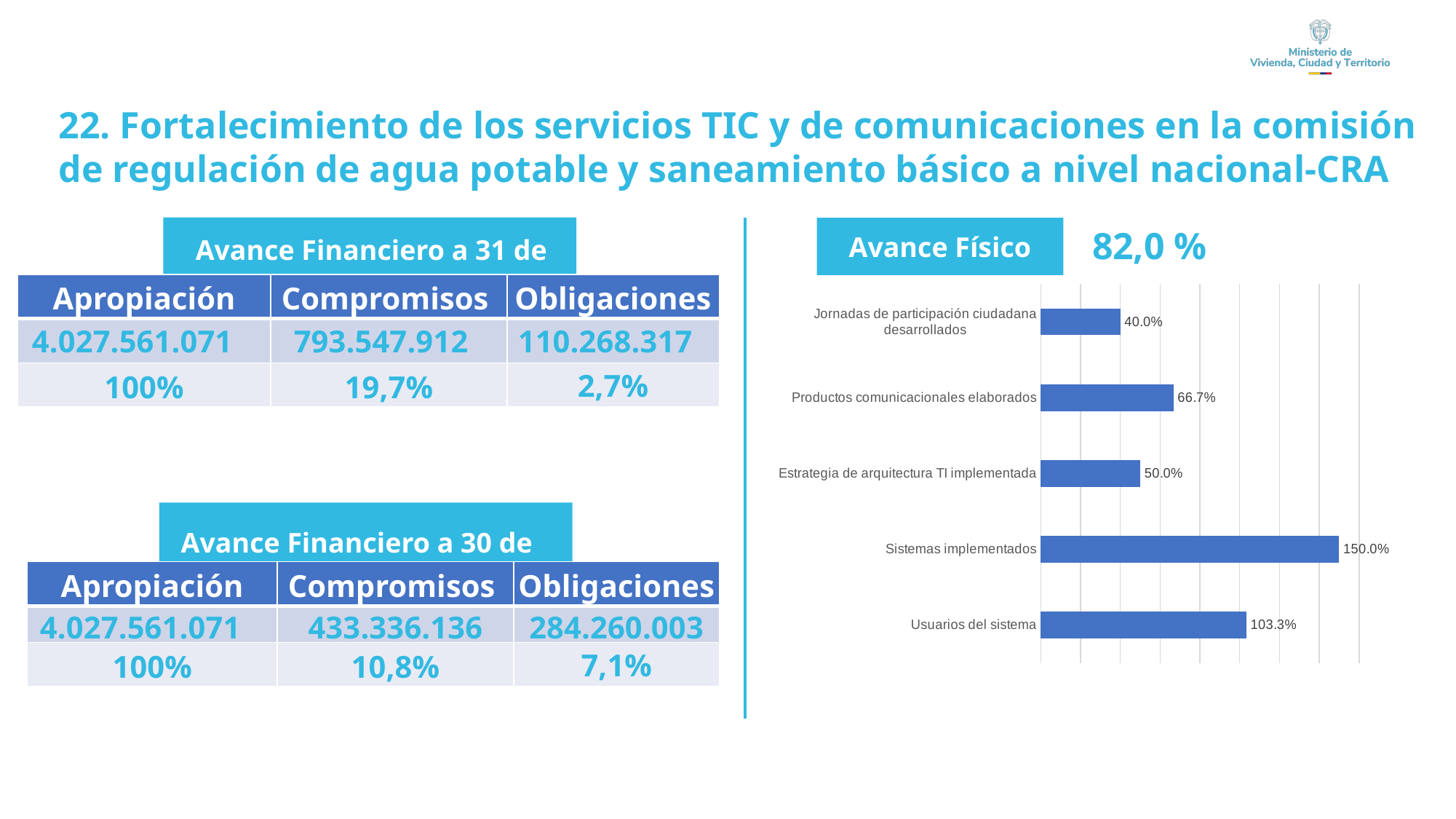
What is the value for Productos comunicacionales elaborados in the bar chart? 66.7% What is the difference between the values for Estrategia de arquitectura TI implementada and Jornadas de participación ciudadana desarrollados in the bar chart? 10.0% Which is larger in the bar chart: Estrategia de arquitectura TI implementada or Productos comunicacionales elaborados? Productos comunicacionales elaborados What kind of chart is shown on the right side of the slide? Bar chart What is the value for Sistemas implementados in the bar chart? 150.0% What is the difference between the values for Sistemas implementados and Usuarios del sistema in the bar chart? 46.7% Which category has the highest value in the bar chart? Sistemas implementados How many categories are shown in the bar chart? 5 What is the value for Jornadas de participación ciudadana desarrollados in the bar chart? 40.0% Which category has the lowest value in the bar chart? Jornadas de participación ciudadana desarrollados What is the Avance Físico percentage shown next to the chart heading? 82,0 % What is the value for Usuarios del sistema in the bar chart? 103.3%